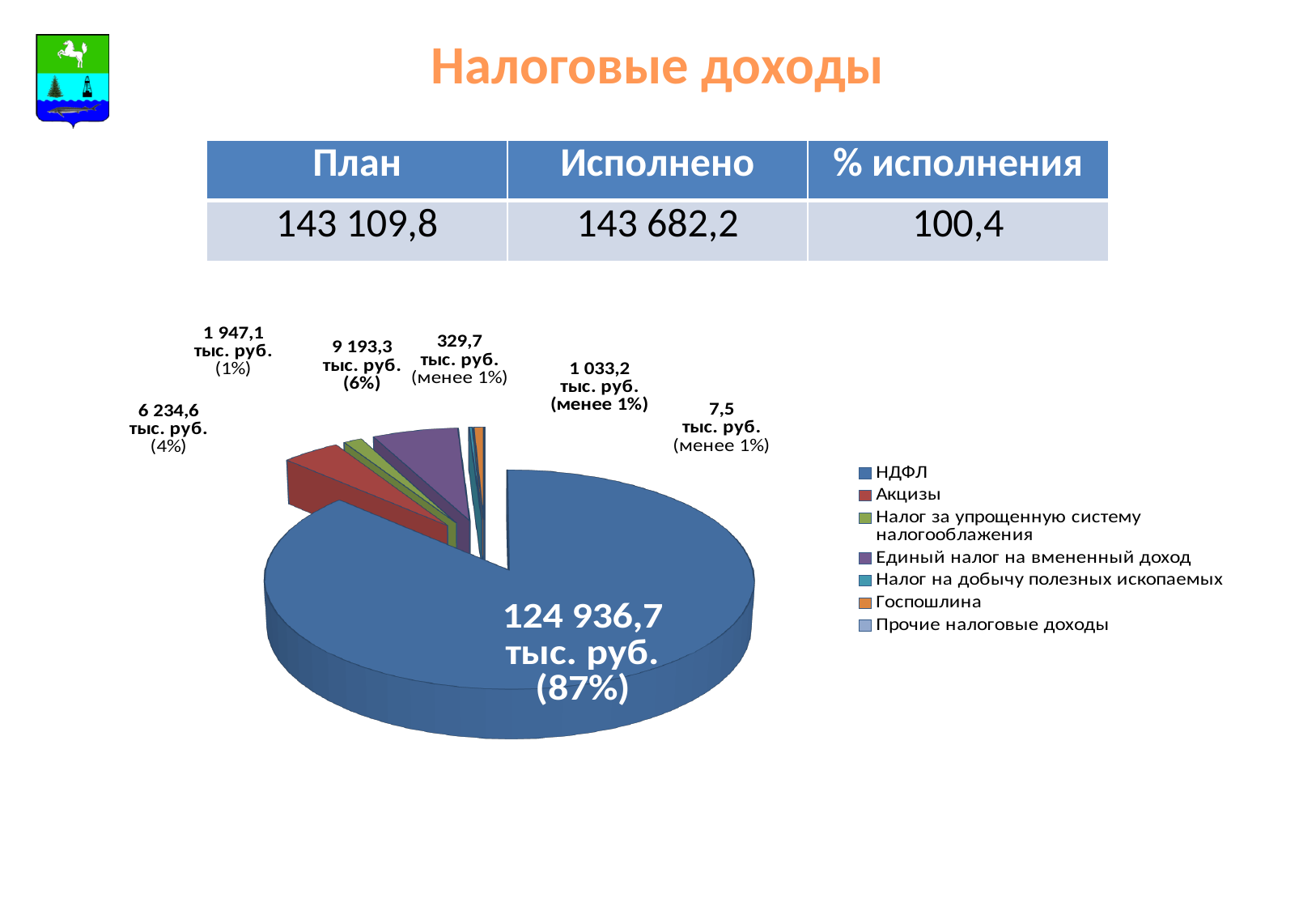
What share of the pie does НДФЛ account for? 87% What value is shown for Акцизы on the pie chart? 6 234,6 тыс. руб. What kind of chart is shown on the slide? pie chart How many categories does the legend of the pie chart list? 7 What is the title of the slide containing the pie chart? Налоговые доходы What is the difference between the values for Единый налог на вмененный доход and Акцизы? 2 958,7 тыс. руб. Which category has the largest slice of the pie chart? НДФЛ What share of the pie does Единый налог на вмененный доход account for? 6% What value is shown for НДФЛ on the pie chart? 124 936,7 тыс. руб. Which category has the smallest slice of the pie chart? Прочие налоговые доходы Which is larger, the value for НДФЛ or the value for Акцизы? НДФЛ What value is shown for Единый налог на вмененный доход on the pie chart? 9 193,3 тыс. руб.